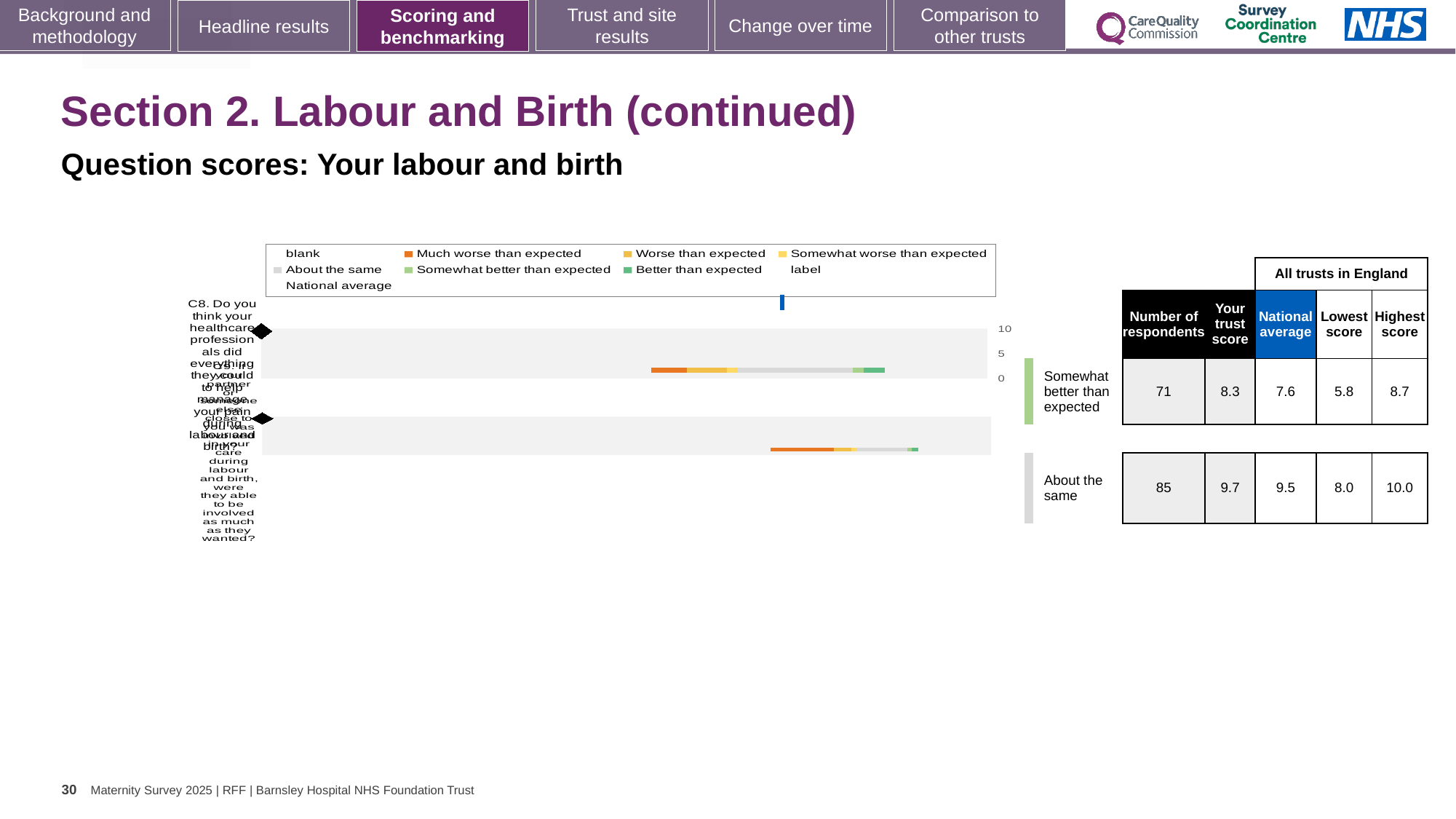
What colour represents 'Much worse than expected' in the chart legend? orange What is the national average for the question rated 'About the same'? 9.5 What is the lowest score across all trusts in England for the question rated 'Somewhat better than expected'? 5.8 For the question rated 'About the same', what is the difference between the trust score and the national average? 0.2 For the question rated 'Somewhat better than expected', which is larger: the trust score or the national average? the trust score How many respondents answered the question rated 'Somewhat better than expected'? 71 For the question rated 'Somewhat better than expected', what is the difference between the trust score and the national average? 0.7 Which of the two questions has the larger number of respondents? About the same How many survey questions are plotted as bars in the chart? 2 What is the 'Your trust score' for the question rated 'Somewhat better than expected'? 8.3 What kind of chart is shown on the slide? bar chart What is the highest score across all trusts in England for the question rated 'About the same'? 10.0